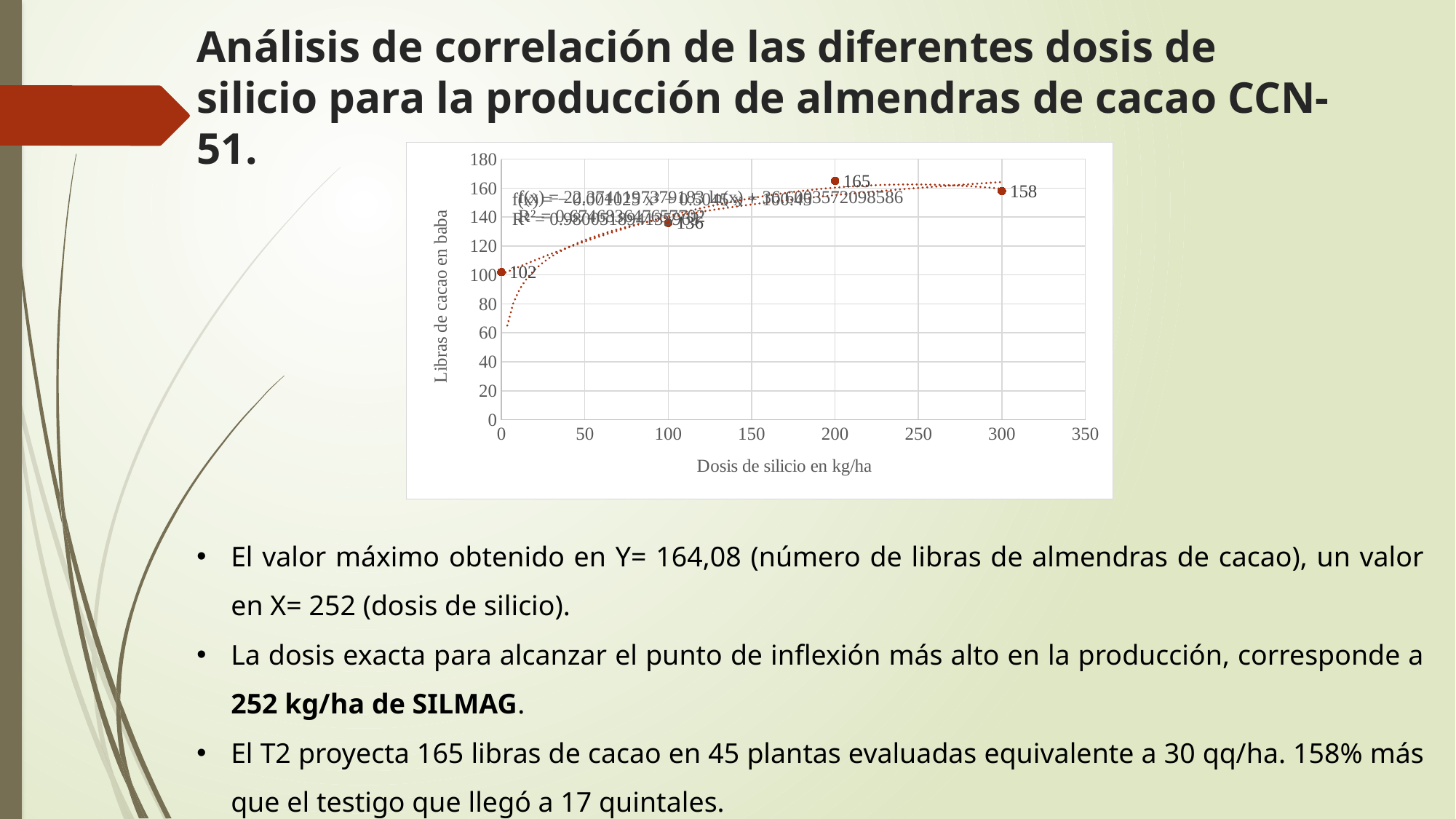
What is the value of libras de cacao en baba at a silicon dose of 200 kg/ha? 165 At which silicon dose is the plotted value of libras de cacao en baba lowest? 0 kg/ha What is the label of the x axis of the chart? Dosis de silicio en kg/ha At which silicon dose is the plotted value of libras de cacao en baba highest? 200 kg/ha Which is larger, the value at 200 kg/ha or the value at 300 kg/ha? 200 kg/ha How many data points are plotted in the chart? 4 What is the value of libras de cacao en baba at a silicon dose of 300 kg/ha? 158 What is the value of libras de cacao en baba at a silicon dose of 0 kg/ha? 102 What is the value of libras de cacao en baba at a silicon dose of 100 kg/ha? 136 What type of chart is shown on the slide? Scatter plot What is the difference between the values at 200 kg/ha and 0 kg/ha of silicon? 63 What is the label of the y axis of the chart? Libras de cacao en baba